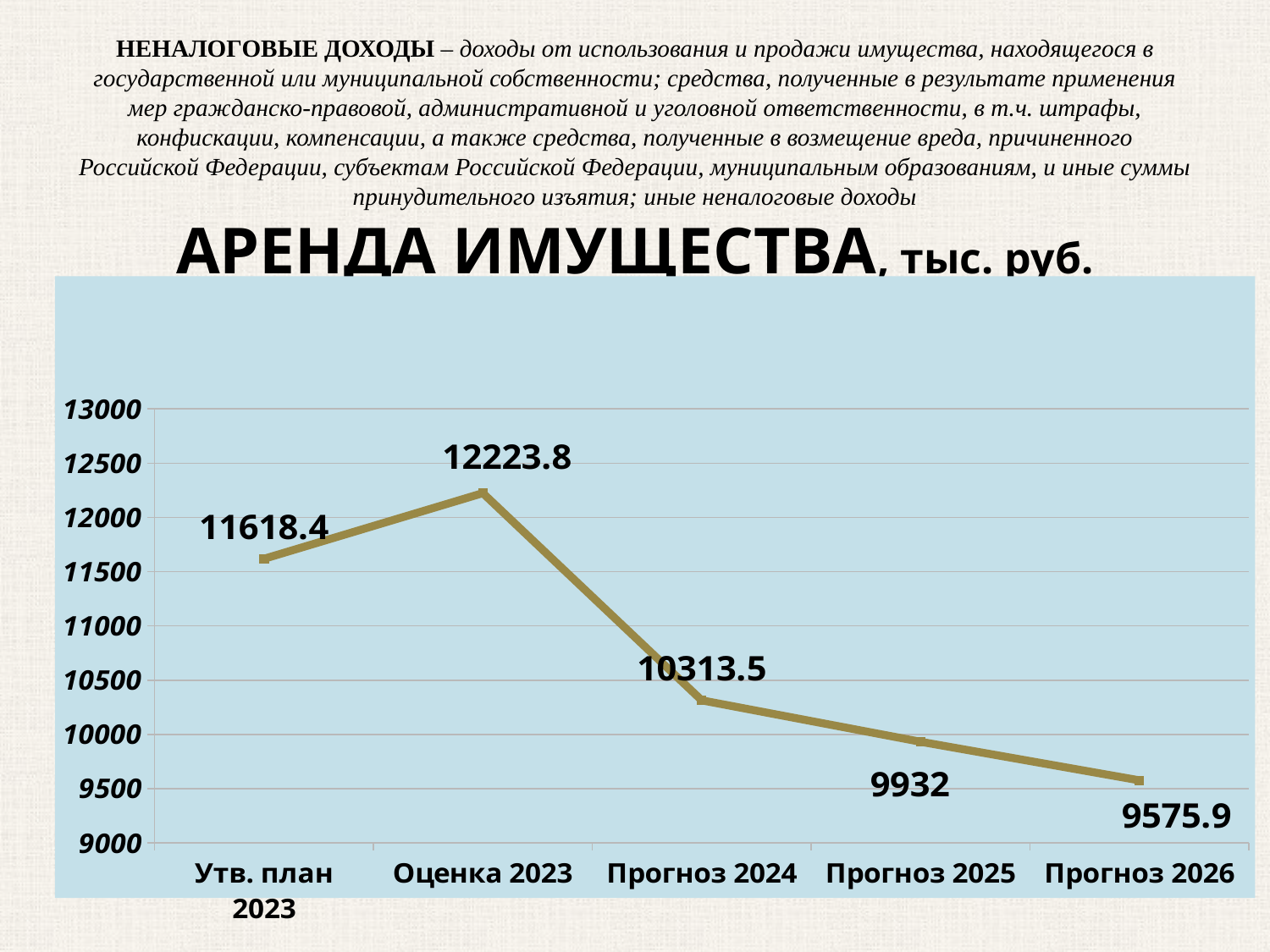
What is the value for Прогноз 2025? 9932 Which is larger, the value for Прогноз 2024 or the value for Прогноз 2025? Прогноз 2024 What kind of chart is shown on the slide? Line chart Which category has the lowest value? Прогноз 2026 What is the value for Оценка 2023 on the chart? 12223.8 Do the values rise or fall from Оценка 2023 to Прогноз 2026? Fall Which category has the highest value? Оценка 2023 How many data points are plotted on the chart? 5 What is the difference between the values for Оценка 2023 and Прогноз 2024? 1910.3 What is the difference between the values for Утв. план 2023 and Прогноз 2026? 2042.5 What is the value for Прогноз 2026? 9575.9 What is the value for Утв. план 2023? 11618.4